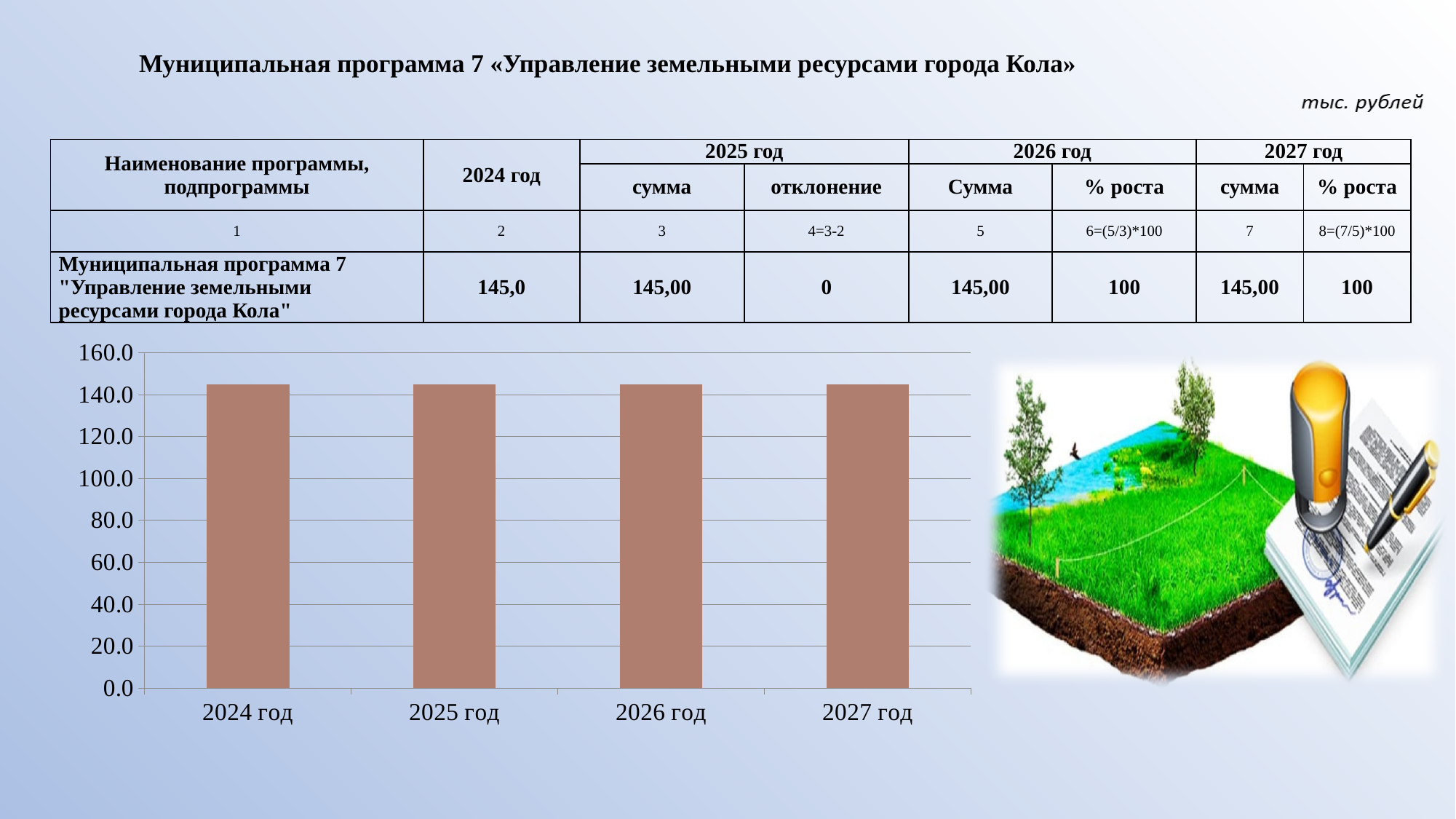
What kind of chart is shown on the slide? bar chart Is the value for 2026 год greater or less than 160? less Do the values rise, fall or stay the same from 2024 год to 2027 год? stay the same Which years are shown on the x axis of the chart? 2024 год, 2025 год, 2026 год, 2027 год How many bars (categories) does the chart show? 4 According to the table on the slide, what is the amount for 2024 год? 145,0 According to the table on the slide, what is the amount (сумма) for 2026 год? 145,00 What is the highest tick value shown on the y axis of the chart? 160.0 Is the value for 2024 год greater or less than 140? greater Is the value for 2027 год greater or less than 120? greater What is the difference between the amounts for 2025 год and 2024 год as shown in the table (отклонение)? 0